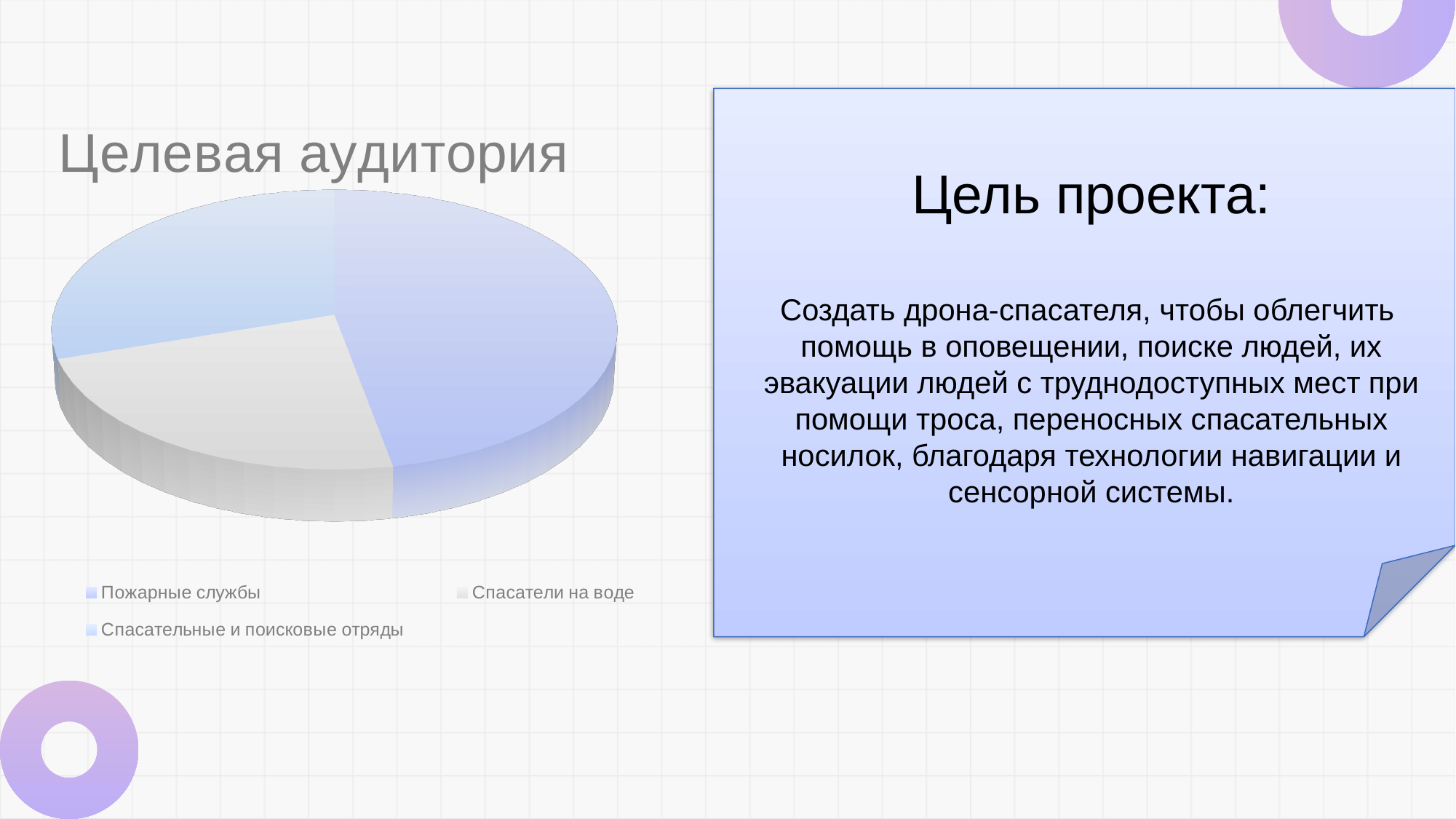
How many slices does the pie chart have? 3 Which slice is larger: Пожарные службы or Спасательные и поисковые отряды? Пожарные службы Which category has the largest slice in the pie chart? Пожарные службы Which category is shown in grey in the pie chart? Спасатели на воде How many entries does the legend of the pie chart list? 3 Which slice is larger: Пожарные службы or Спасатели на воде? Пожарные службы What kind of chart is shown on the slide? pie chart What is the title of the pie chart? Целевая аудитория